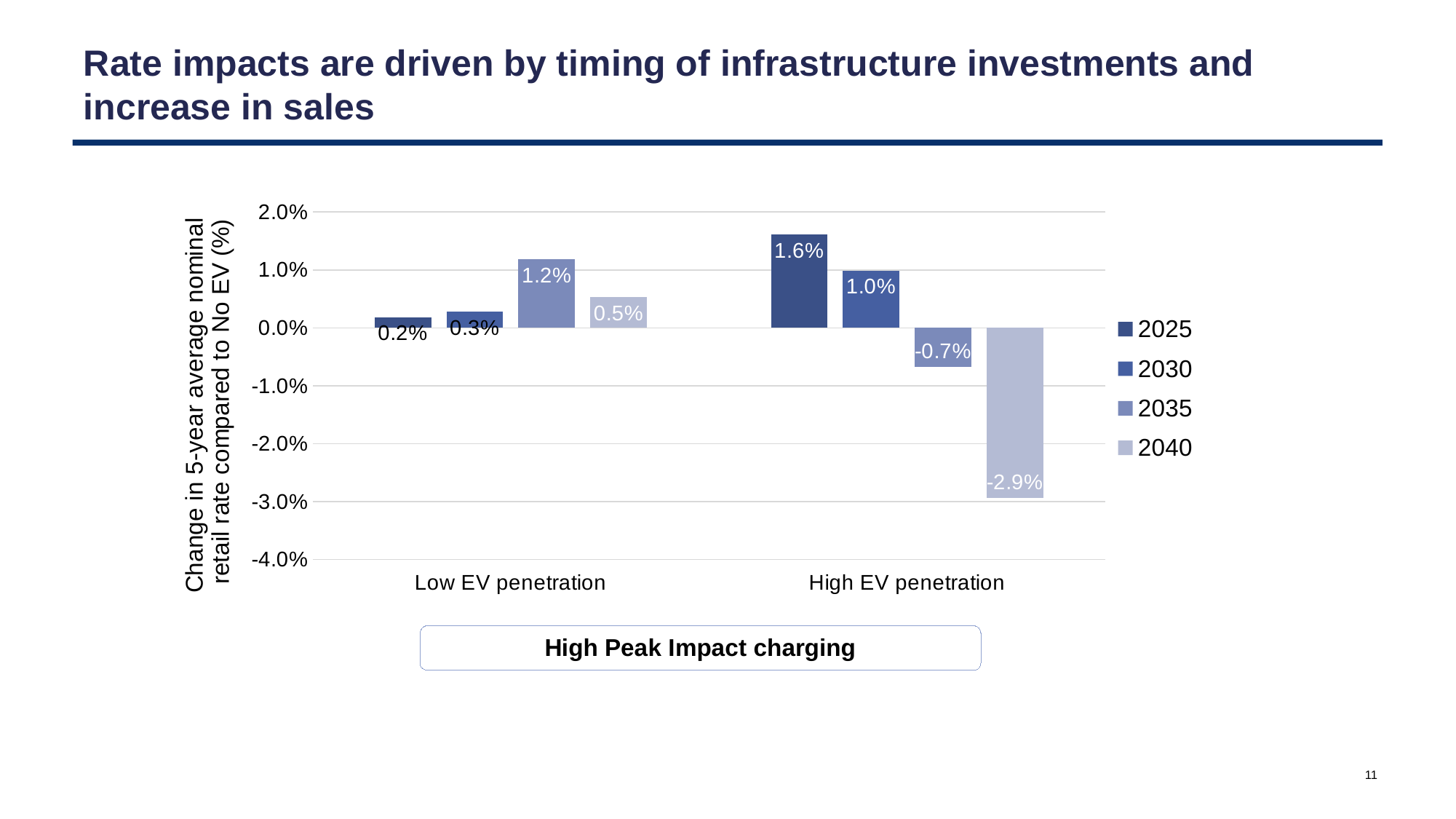
How many series does the legend list? 4 How many categories are shown on the x axis? 2 What is the value for 2035 under Low EV penetration? 1.2% Which year has the highest value under High EV penetration? 2025 Which year has the lowest value under High EV penetration? 2040 What is the value for 2030 under Low EV penetration? 0.3% What is the difference between the 2025 values for High EV penetration and Low EV penetration? 1.4% What is the value for 2040 under High EV penetration? -2.9% What is the value for 2025 under High EV penetration? 1.6% What kind of chart is shown on the slide? Bar chart Which year has the highest value under Low EV penetration? 2035 Which is larger: the 2030 value under Low EV penetration or under High EV penetration? High EV penetration